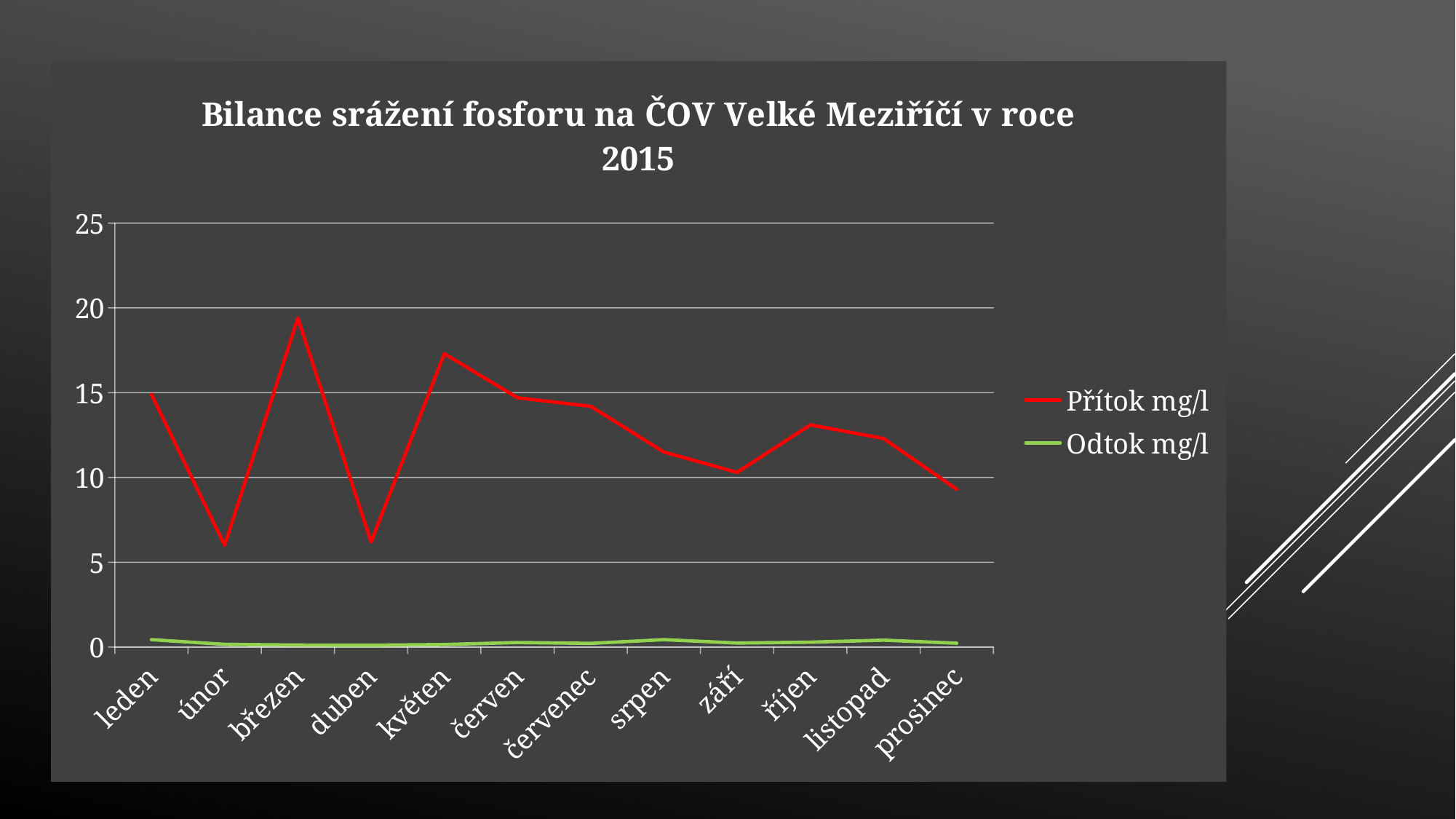
Does the Přítok mg/l series rise or fall from květen to září? fall In which month does the Přítok mg/l series reach its highest value? březen Is the Přítok mg/l value for květen greater or less than 15? greater Is the Přítok mg/l value for únor greater or less than 10? less Is the Přítok mg/l value for březen greater or less than 15? greater What kind of chart is shown on the slide? line chart How many months are plotted along the x axis? 12 Which is larger, the Přítok mg/l value for leden or for únor? leden Which series has the higher values throughout the year, Přítok mg/l or Odtok mg/l? Přítok mg/l What is the title of the chart? Bilance srážení fosforu na ČOV Velké Meziříčí v roce 2015 How many series does the legend list? 2